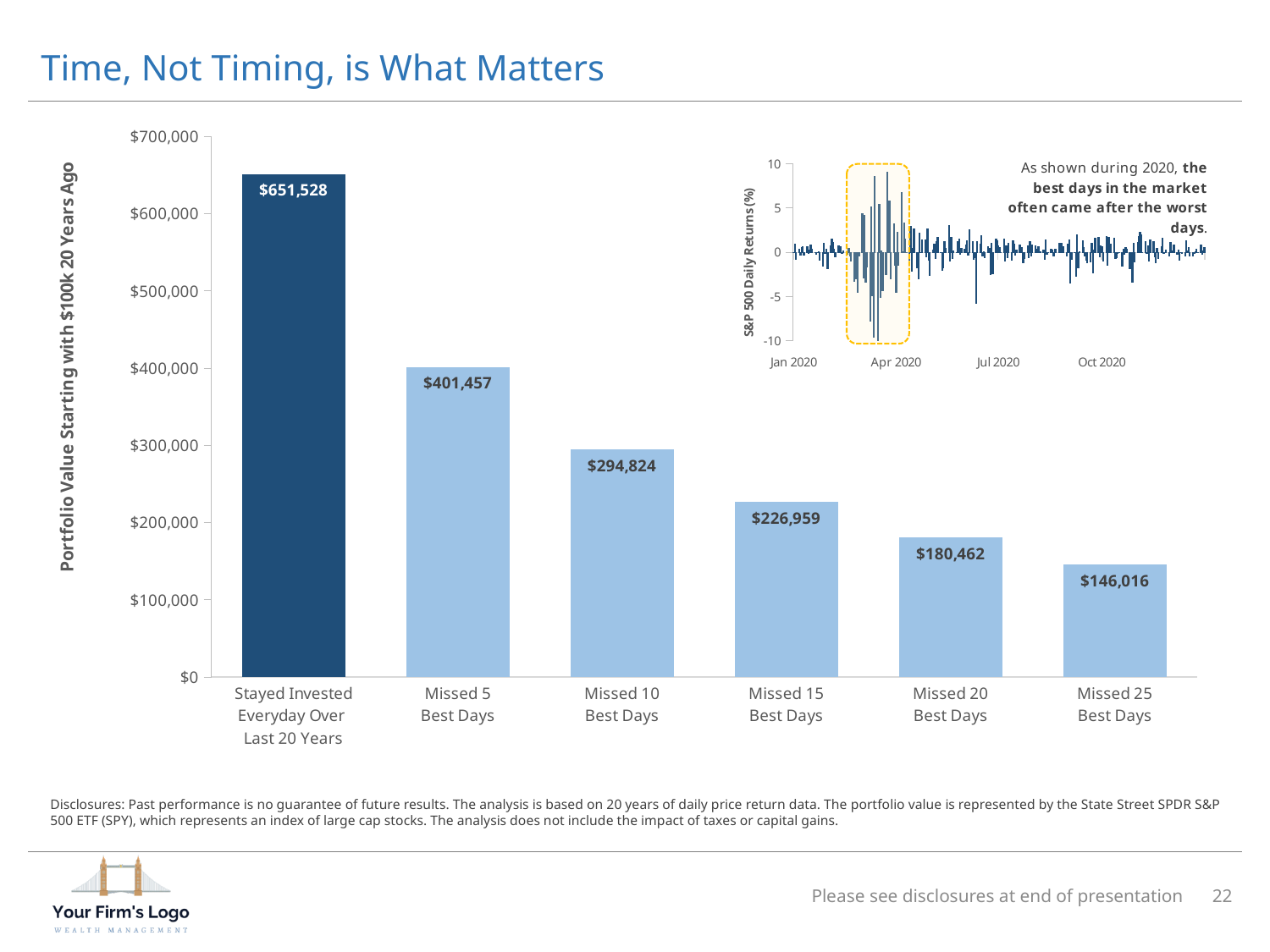
In the main bar chart, what is the portfolio value for 'Missed 10 Best Days'? $294,824 In the main bar chart, what is the portfolio value for 'Missed 25 Best Days'? $146,016 In the main bar chart, what is the difference in portfolio value between 'Stayed Invested Everyday Over Last 20 Years' and 'Missed 5 Best Days'? $250,071 In the main bar chart, do the portfolio values rise or fall moving from left to right along the x axis? Fall In the main bar chart, which category has the highest portfolio value? Stayed Invested Everyday Over Last 20 Years In the main bar chart, what is the difference in portfolio value between 'Missed 20 Best Days' and 'Missed 25 Best Days'? $34,446 In the main bar chart, what is the portfolio value for 'Stayed Invested Everyday Over Last 20 Years'? $651,528 What is the y-axis label of the small inset chart in the upper right? S&P 500 Daily Returns (%) In the main bar chart, which category has the lowest portfolio value? Missed 25 Best Days What kind of chart is the main chart on the slide? Bar chart In the main bar chart, how many categories are shown on the x axis? 6 In the main bar chart, which is larger: the portfolio value for 'Missed 15 Best Days' or 'Missed 20 Best Days'? Missed 15 Best Days